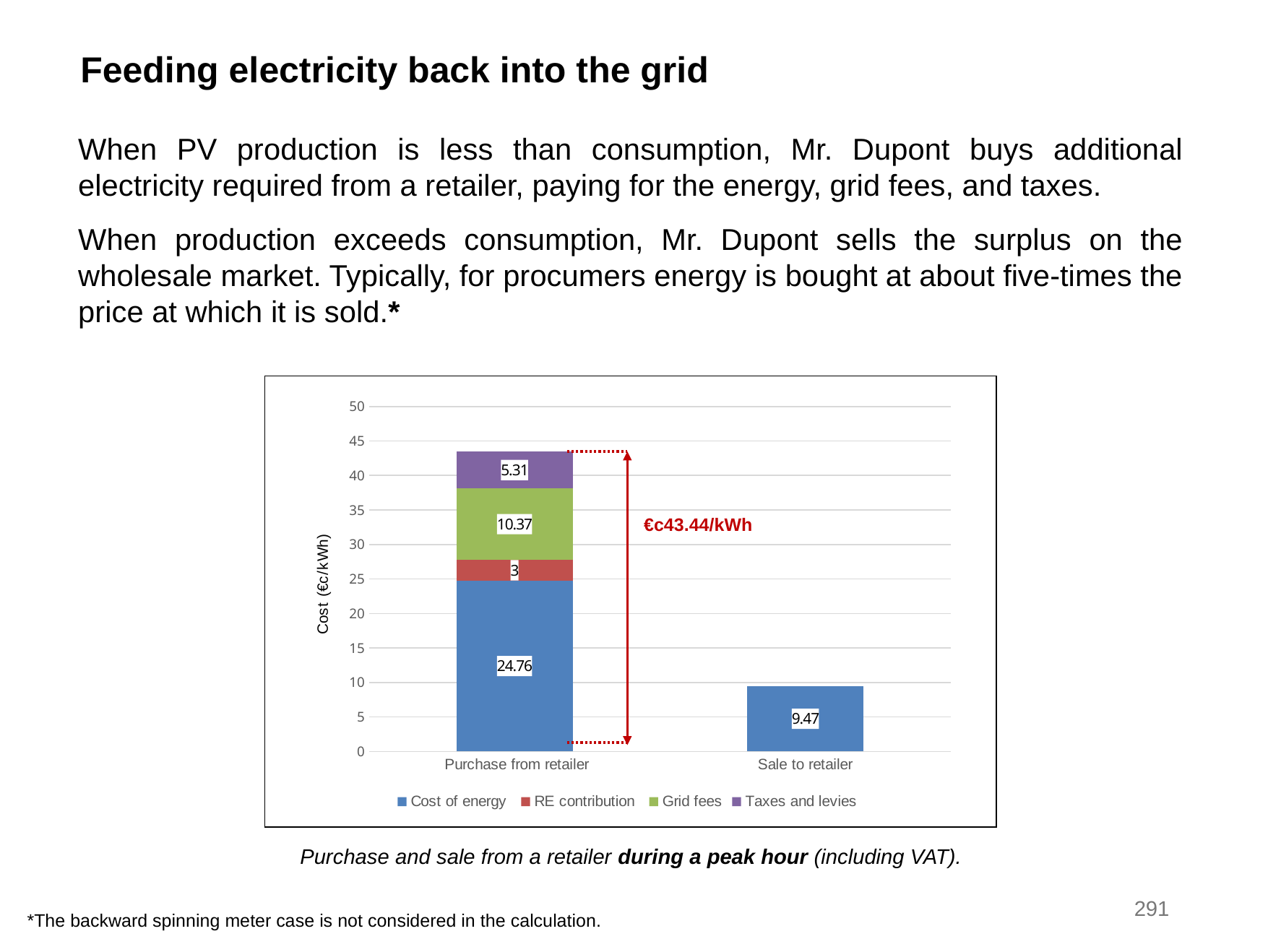
What is the value of Cost of energy for Sale to retailer? 9.47 What is the value of RE contribution for Purchase from retailer? 3 What is the value of Taxes and levies for Purchase from retailer? 5.31 What is the label on the y axis? Cost (€c/kWh) What kind of chart is shown? Stacked bar chart How many series does the legend list? 4 Which is larger for Purchase from retailer: Cost of energy or Grid fees? Cost of energy What is the value of Cost of energy for Purchase from retailer? 24.76 What is the value of Grid fees for Purchase from retailer? 10.37 Which segment of the Purchase from retailer bar is the smallest? RE contribution What is the total of the stacked bar for Purchase from retailer? 43.44 What is the difference between Grid fees and Taxes and levies for Purchase from retailer? 5.06